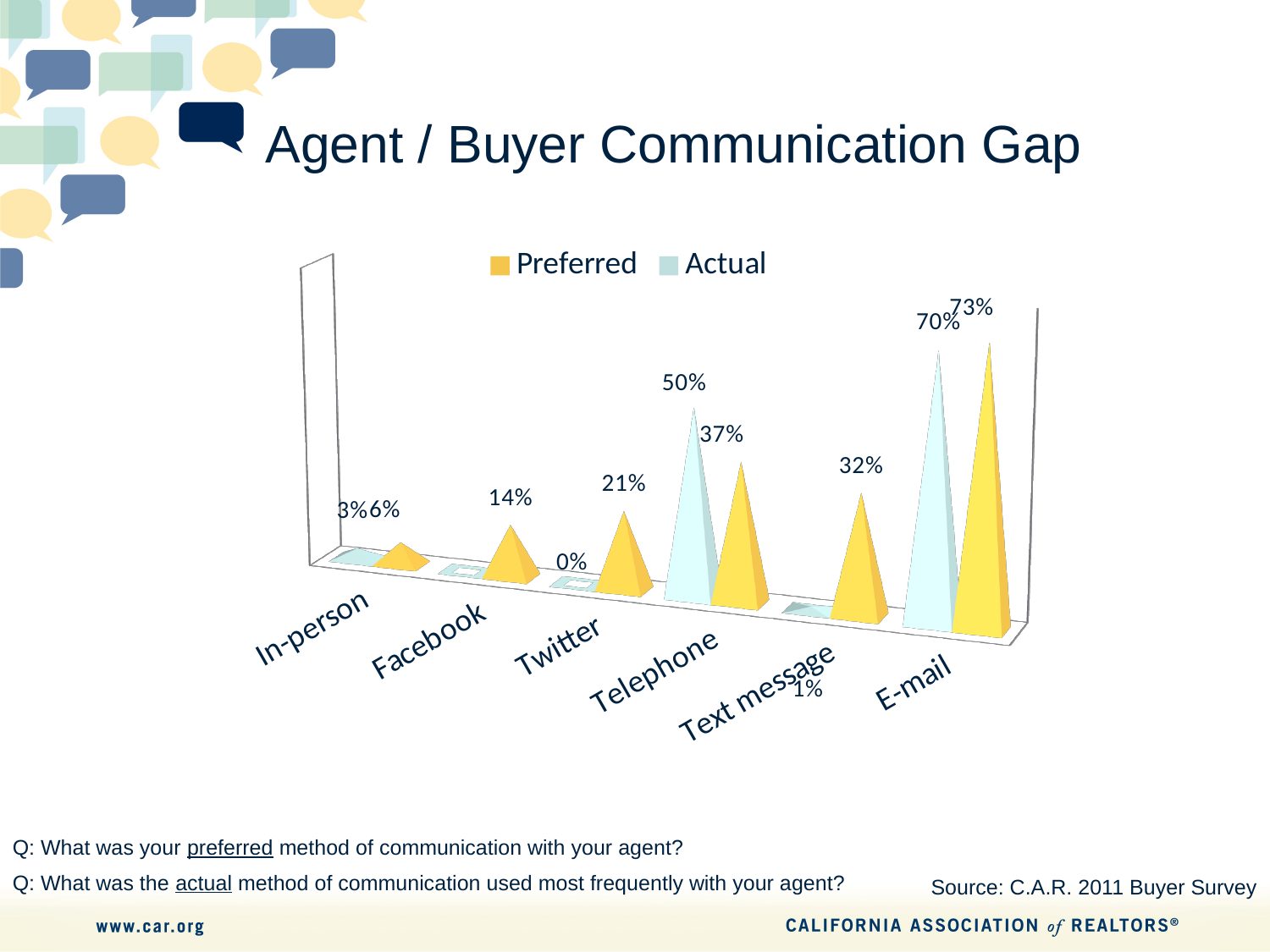
What is the Actual value for Twitter? 0% What is the difference between the Actual and Preferred values for Telephone? 13 percentage points What is the Preferred value for Facebook? 14% What is the Actual value for Telephone? 50% Which communication method has the lowest Preferred value? In-person How many communication methods are shown on the x axis? 6 How many series does the legend list? 2 What is the Preferred value for E-mail? 73% What is the Preferred value for Text message? 32% For Telephone, which is larger: the Preferred value or the Actual value? Actual What kind of chart is shown on the slide? Bar chart Which communication method has the highest Preferred value? E-mail